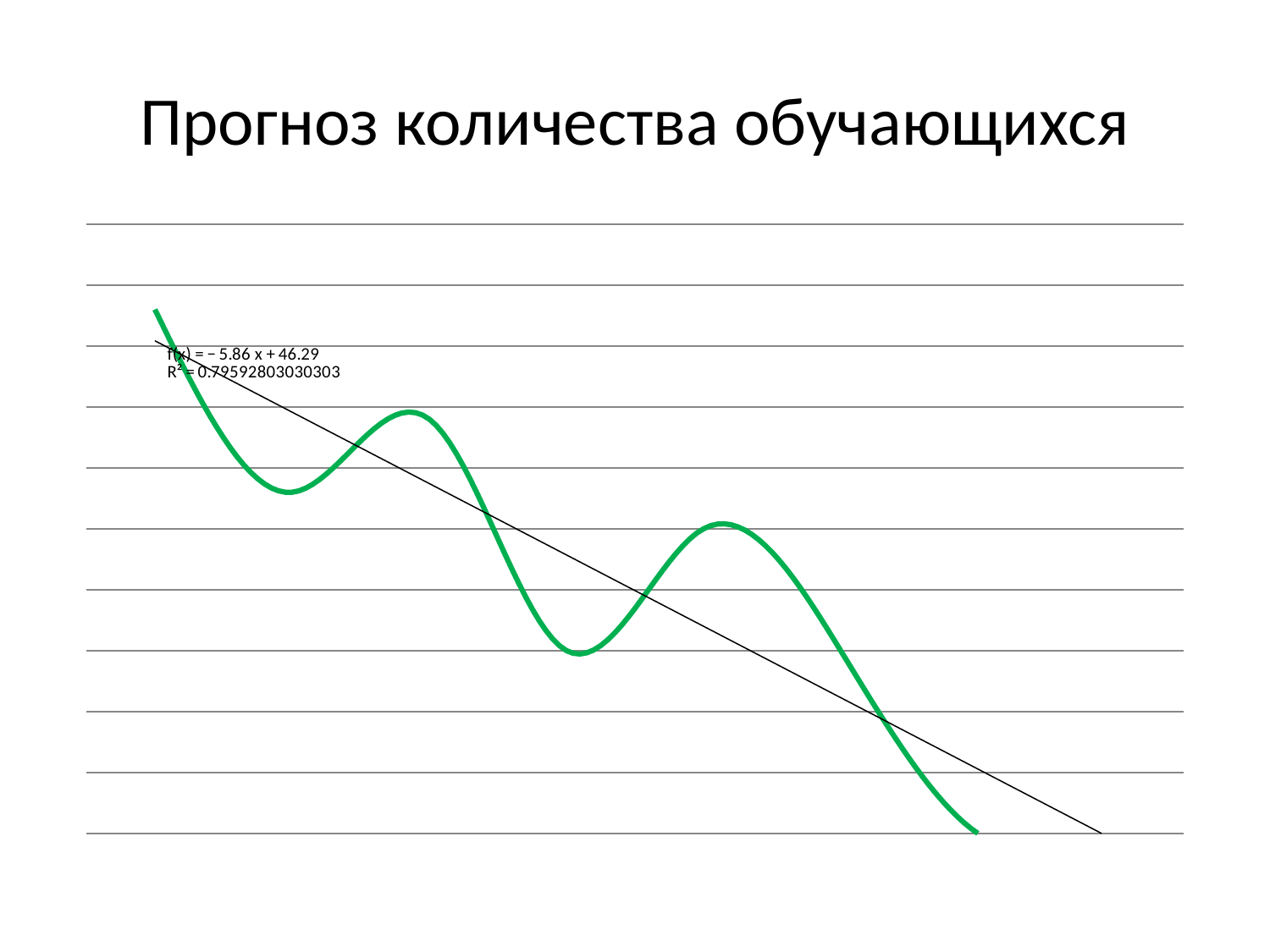
What kind of chart is shown on the slide? line chart Do the values of the green line generally rise or fall along the x axis? fall What trendline equation is printed on the chart? f(x) = − 5.86 x + 46.29 What is the title of the chart? Прогноз количества обучающихся